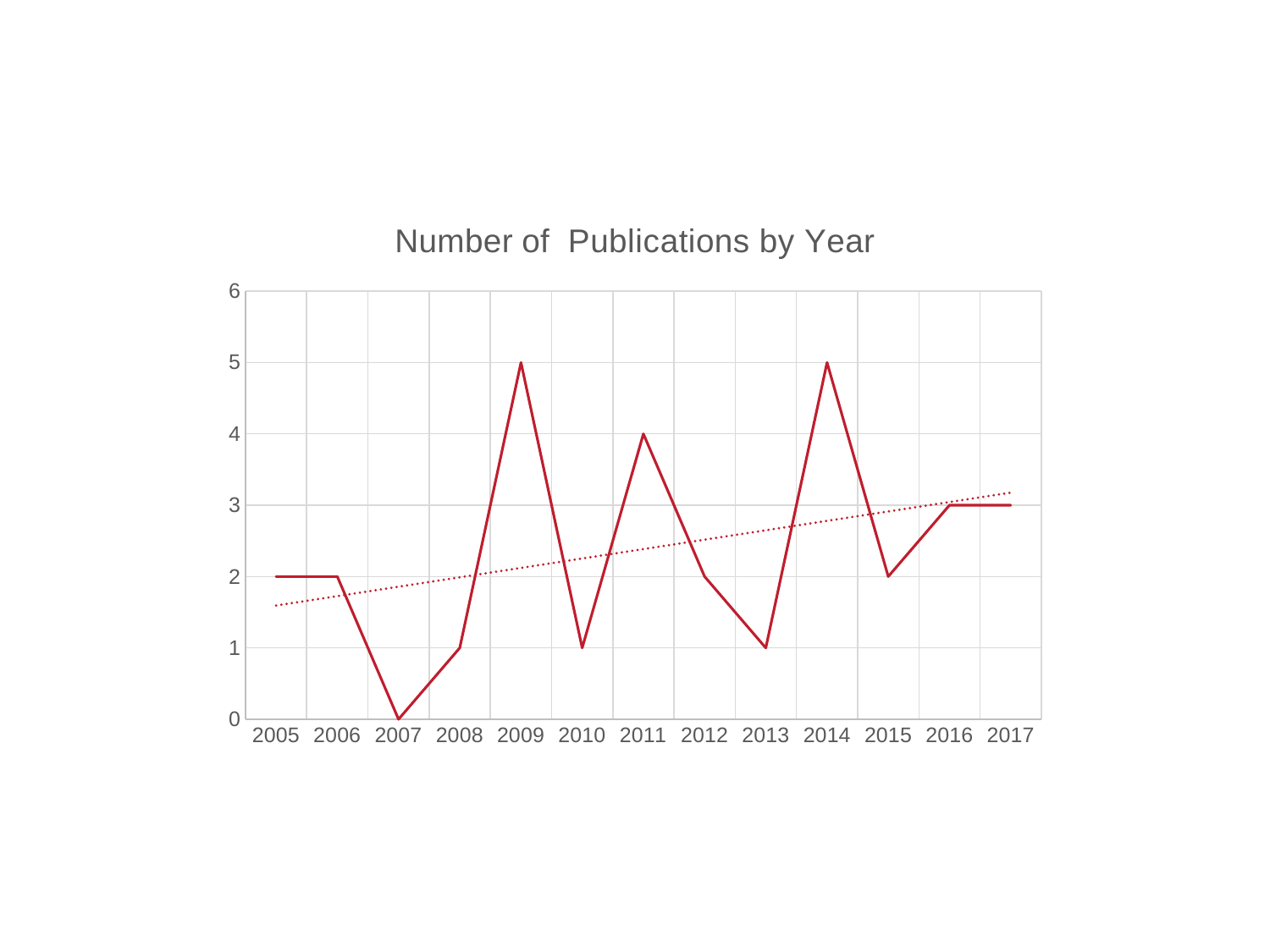
Is the value for 2013 greater or less than 2? less What is the number of publications in 2007? 0 What kind of chart is shown on the slide? line chart Which year has the lowest number of publications? 2007 Which year has more publications, 2011 or 2012? 2011 What is the title of the chart? Number of Publications by Year Does the dotted trend line rise or fall from 2005 to 2017? rise What is the number of publications in 2016? 3 What is the number of publications in 2011? 4 What is the number of publications in 2009? 5 What is the difference in publications between 2014 and 2015? 3 How many years are plotted on the x axis? 13